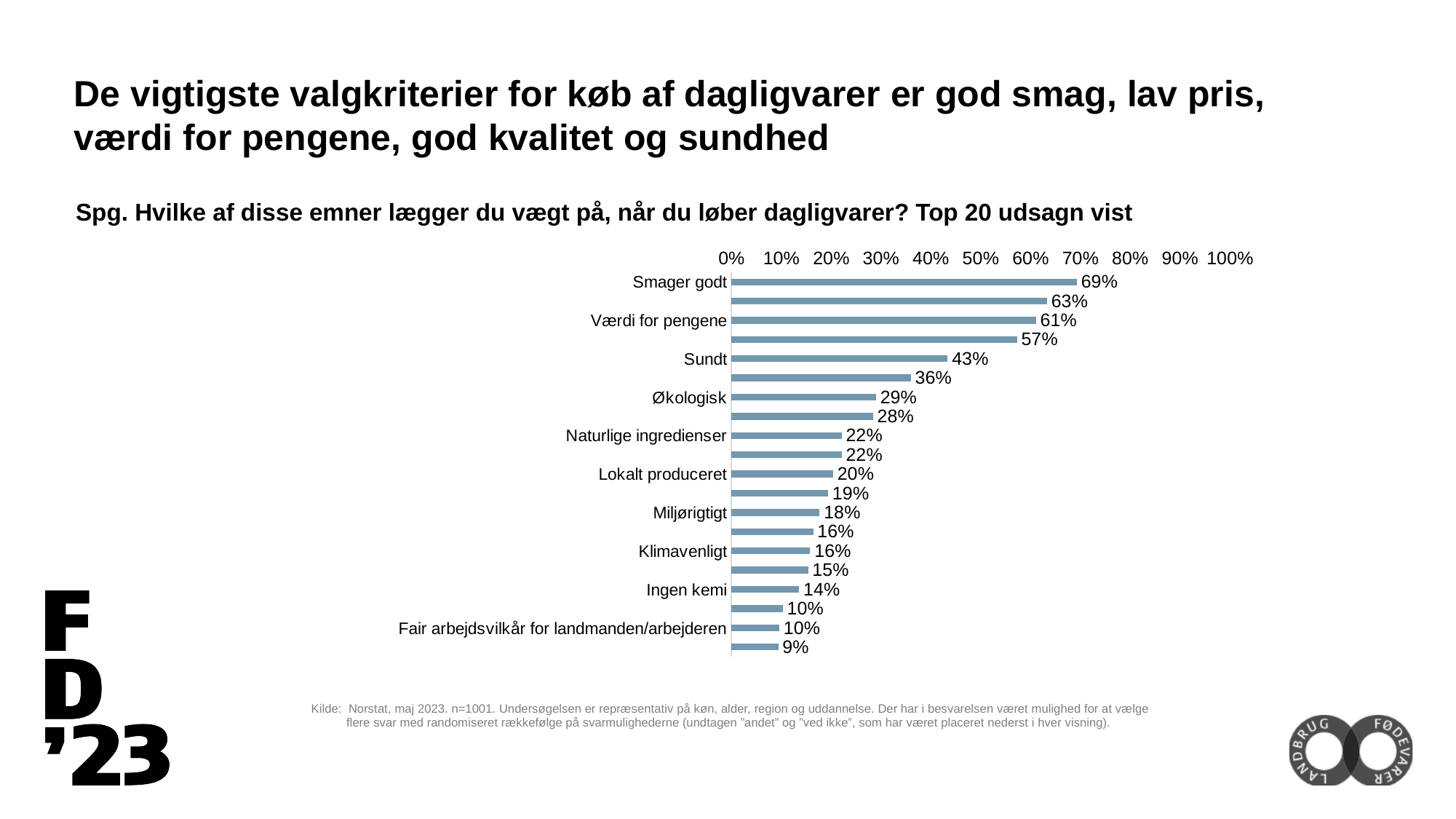
What is the value for Smager godt? 69% What is the value for Økologisk? 29% What is the value for Værdi for pengene? 61% What is the value for Sundt? 43% What is the difference between the values for Smager godt and Sundt? 26% How many bars are plotted in the chart? 20 What is the value for Fair arbejdsvilkår for landmanden/arbejderen? 10% Which is larger, the value for Miljørigtigt or the value for Klimavenligt? Miljørigtigt Is the value for Ingen kemi greater or less than 20%? less Which labelled category has the highest value? Smager godt What is the value for Lokalt produceret? 20% What kind of chart is shown on the slide? bar chart